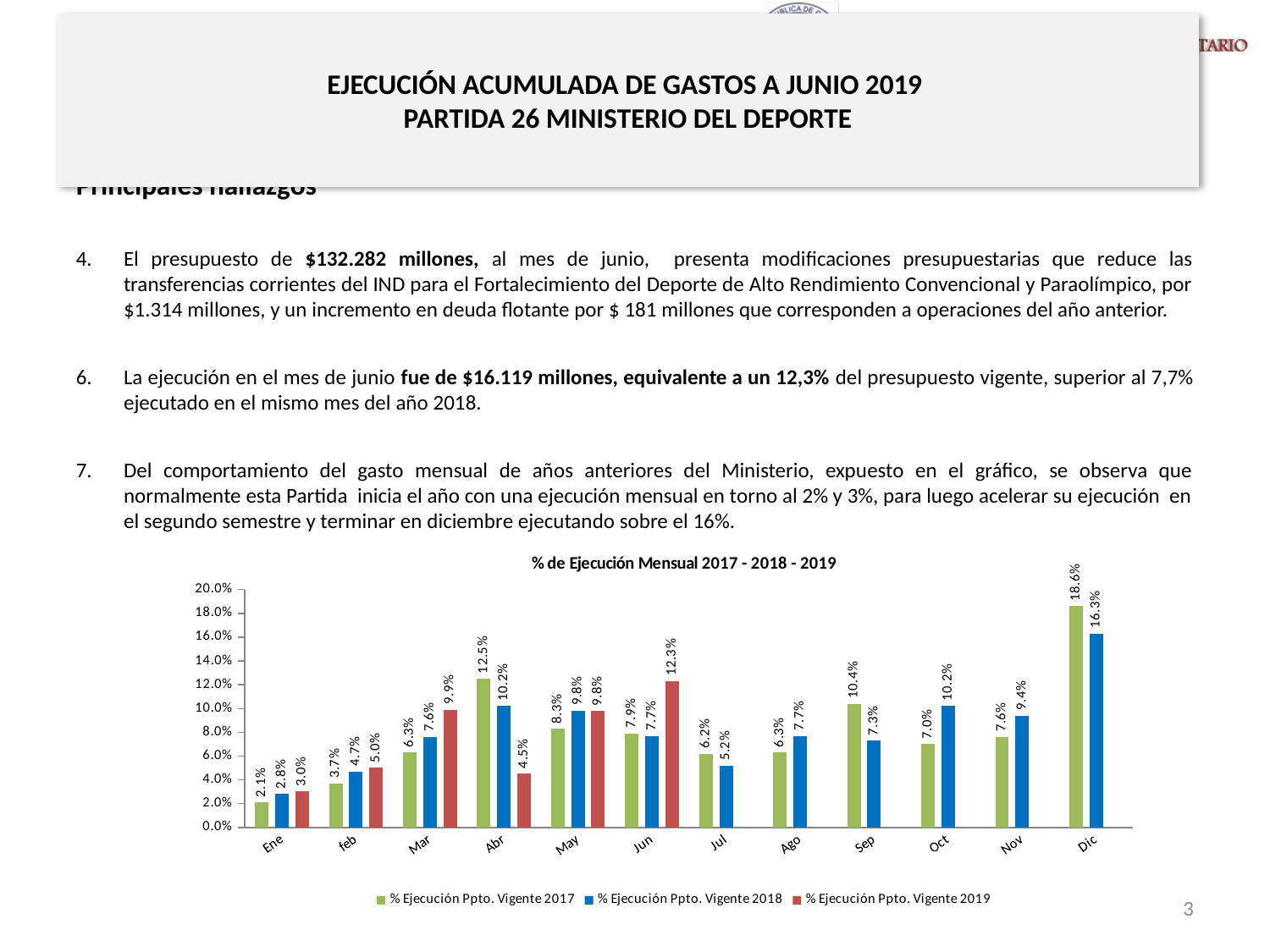
What is the % Ejecución Ppto. Vigente 2017 value for Abr? 12.5% Which month has the highest % Ejecución Ppto. Vigente 2017 value? Dic What is the % Ejecución Ppto. Vigente 2018 value for Oct? 10.2% Is the % Ejecución Ppto. Vigente 2017 value for Sep greater or less than 8.0%? greater How many months are shown on the x axis? 12 Which month has the lowest % Ejecución Ppto. Vigente 2018 value? Ene Which is larger for Abr: the 2018 value or the 2019 value? 2018 What is the title of the chart? % de Ejecución Mensual 2017 - 2018 - 2019 What kind of chart is shown? Bar chart What is the difference between the 2017 and 2018 values for Dic? 2.3% What is the % Ejecución Ppto. Vigente 2019 value for Jun? 12.3% How many series does the legend list? 3